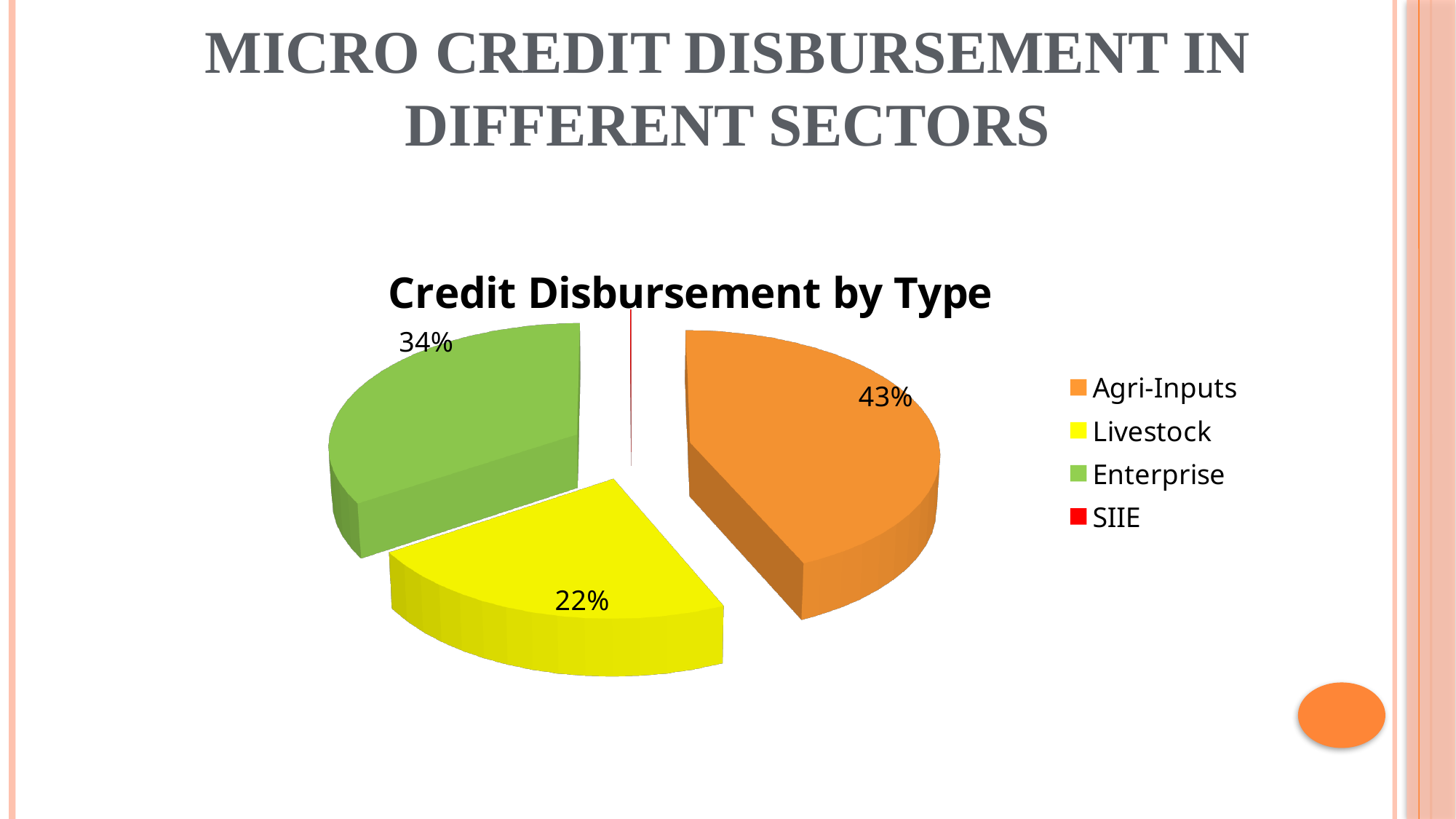
Which category has the largest share of credit disbursement? Agri-Inputs Which colour represents Livestock in the chart? Yellow Among Agri-Inputs, Livestock and Enterprise, which has the smallest share? Livestock What is the difference in percentage points between the Enterprise share and the Livestock share? 12 percentage points What share of credit disbursement goes to Agri-Inputs? 43% How many categories does the legend list? 4 What share of credit disbursement goes to Livestock? 22% What kind of chart is shown on the slide? Pie chart How many percentage points larger is the Agri-Inputs share than the Livestock share? 21 percentage points Which is larger, the Enterprise share or the Livestock share? Enterprise What share of credit disbursement goes to Enterprise? 34% What is the title of the chart? Credit Disbursement by Type